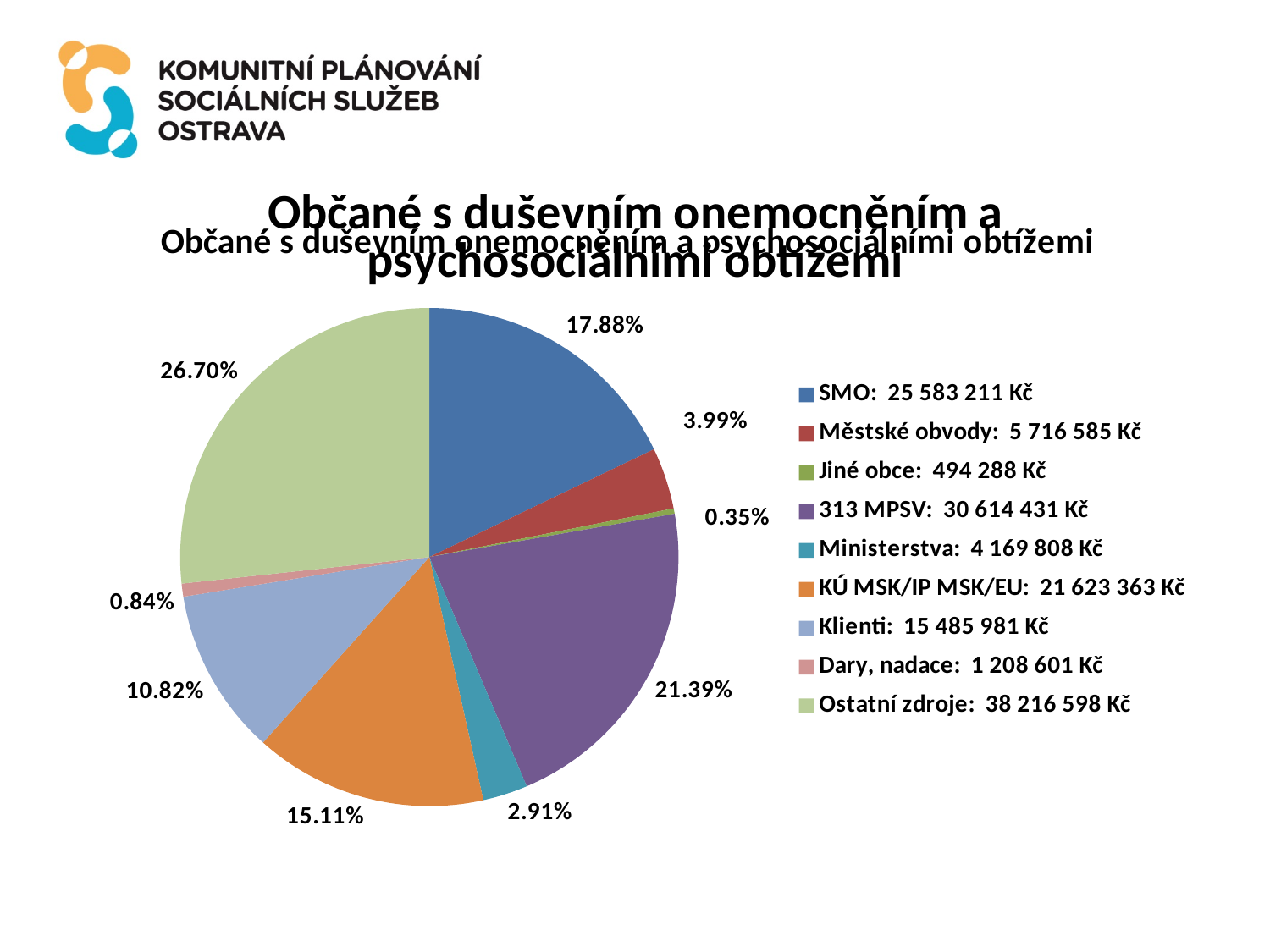
Which slice is larger, KÚ MSK/IP MSK/EU or Klienti? KÚ MSK/IP MSK/EU What percentage share does the 313 MPSV slice have in the pie chart? 21.39% What amount in Kč does the legend give for Klienti? 15 485 981 Kč What type of chart is shown on the slide? pie chart What percentage share does the Ministerstva slice have? 2.91% What amount in Kč does the legend give for SMO? 25 583 211 Kč Which category has the largest slice of the pie chart? Ostatní zdroje What percentage share does the Ostatní zdroje slice have in the pie chart? 26.70% What amount in Kč does the legend give for Dary, nadace? 1 208 601 Kč What is the difference in percentage points between the Ostatní zdroje slice and the SMO slice? 8.82 Which category has the smallest slice of the pie chart? Jiné obce How many categories does the pie chart contain? 9